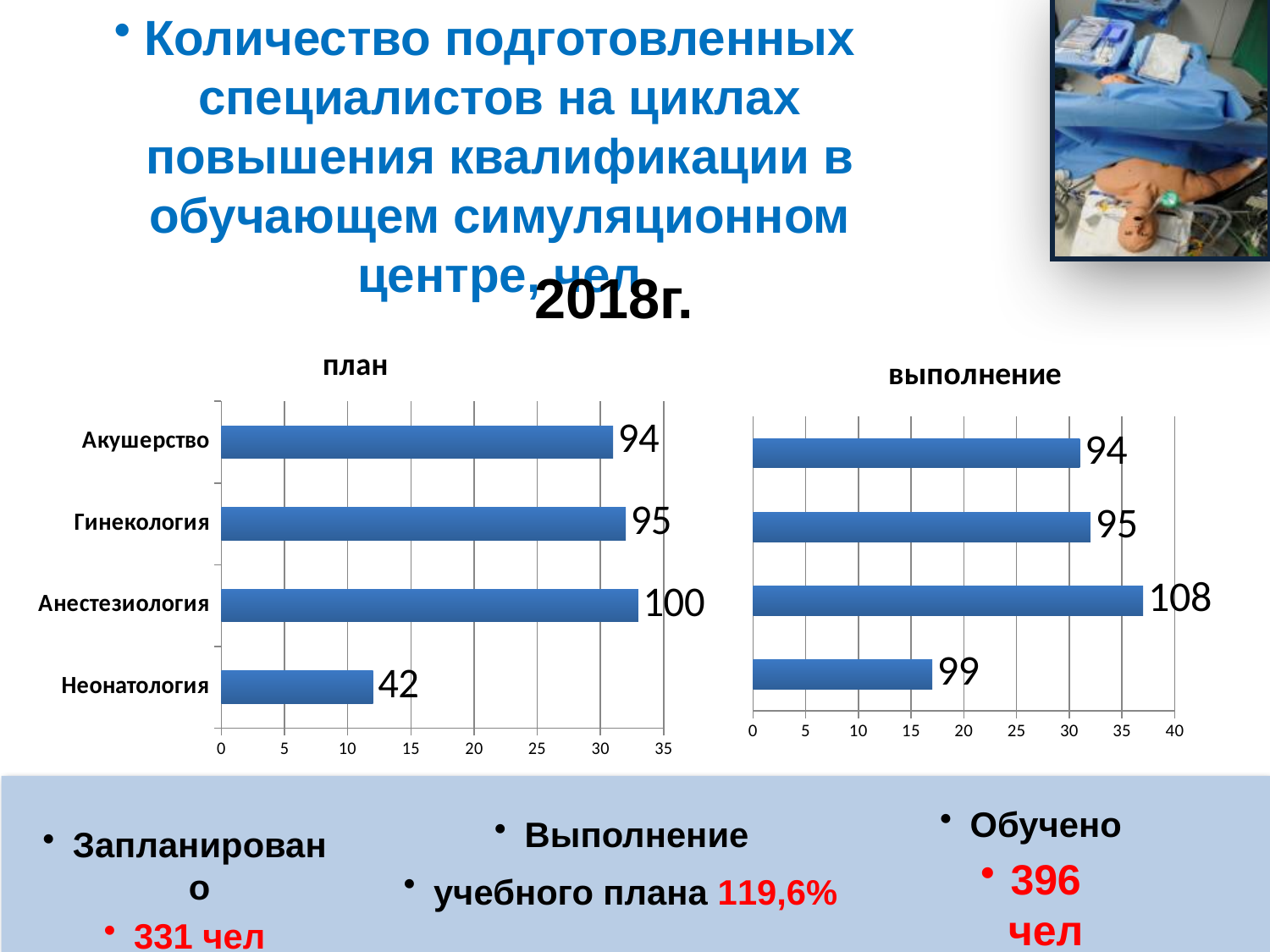
In the chart titled "план", what is the value for Акушерство? 94 In the chart titled "план", which category has the highest value? Анестезиология In the chart titled "план", which is larger: the value for Гинекология or the value for Неонатология? Гинекология In the chart titled "выполнение", what is the highest data label shown? 108 In the chart titled "выполнение", how many bars are shown? 4 In the chart titled "план", what is the value for Неонатология? 42 In the chart titled "план", what is the difference between the values for Анестезиология and Неонатология? 58 What kind of chart is the chart titled "выполнение"? bar chart In the chart titled "выполнение", what is the data label on the bottom bar? 99 What is the title of the chart on the left side of the slide? план In the chart titled "план", how many categories are shown? 4 In the chart titled "план", which category has the lowest value? Неонатология